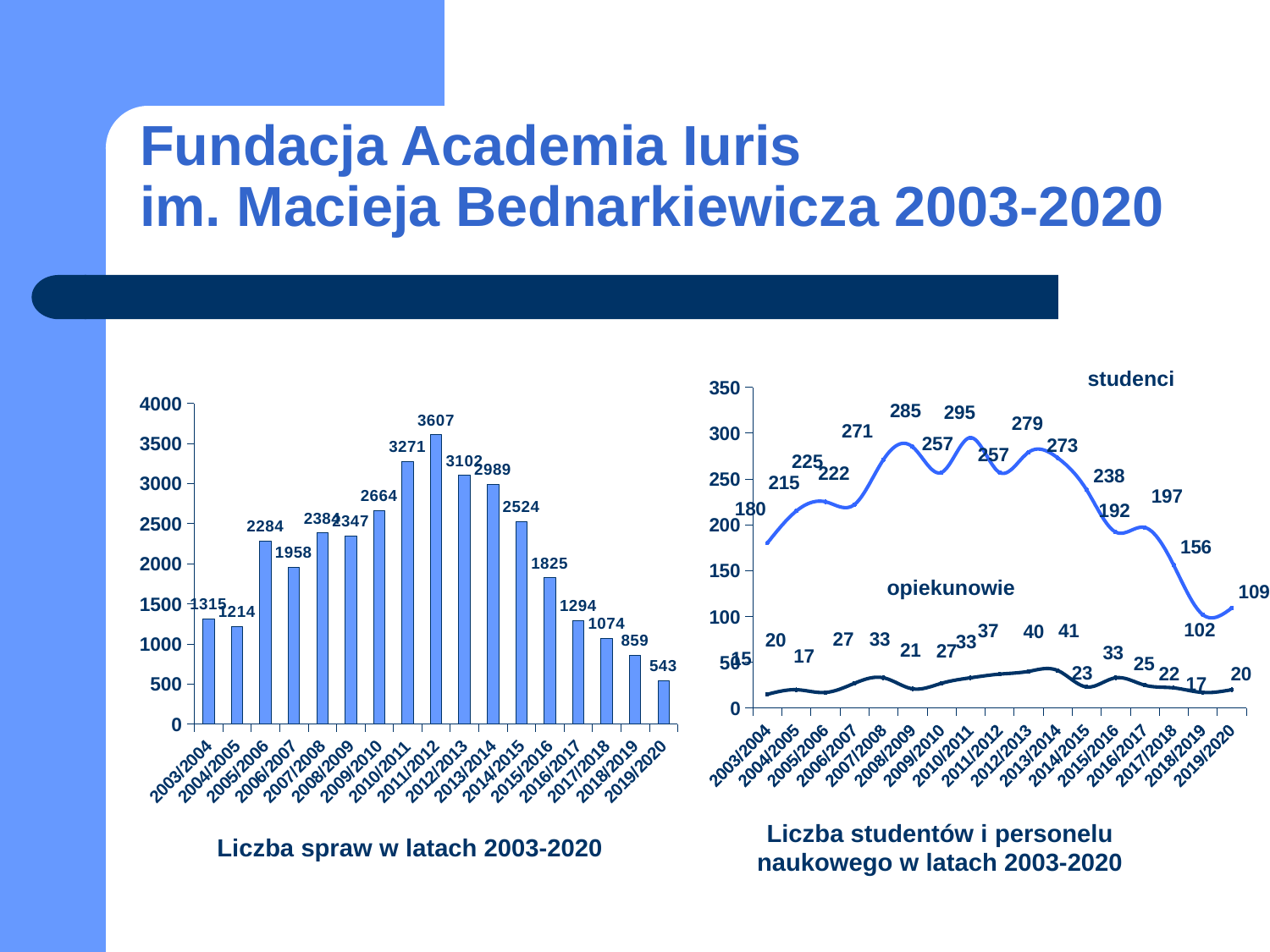
In the chart 'Liczba studentów i personelu naukowego w latach 2003-2020', what is the value of the opiekunowie series for 2013/2014? 41 How many years are shown on the x axis of the chart 'Liczba spraw w latach 2003-2020'? 17 In the chart 'Liczba spraw w latach 2003-2020', what is the value for 2015/2016? 1825 In the chart 'Liczba studentów i personelu naukowego w latach 2003-2020', does the studenci series rise or fall from 2013/2014 to 2018/2019? fall How many series are shown in the chart 'Liczba studentów i personelu naukowego w latach 2003-2020'? 2 In the chart 'Liczba spraw w latach 2003-2020', which year has the lowest value? 2019/2020 In the chart 'Liczba spraw w latach 2003-2020', what is the value for 2011/2012? 3607 In the chart 'Liczba spraw w latach 2003-2020', what is the difference between the values for 2010/2011 and 2009/2010? 607 In the chart 'Liczba spraw w latach 2003-2020', which year has the highest value? 2011/2012 In the chart 'Liczba spraw w latach 2003-2020', which is larger, the value for 2005/2006 or the value for 2006/2007? 2005/2006 What kind of chart is 'Liczba spraw w latach 2003-2020'? bar chart In the chart 'Liczba studentów i personelu naukowego w latach 2003-2020', what is the highest value of the studenci series? 295